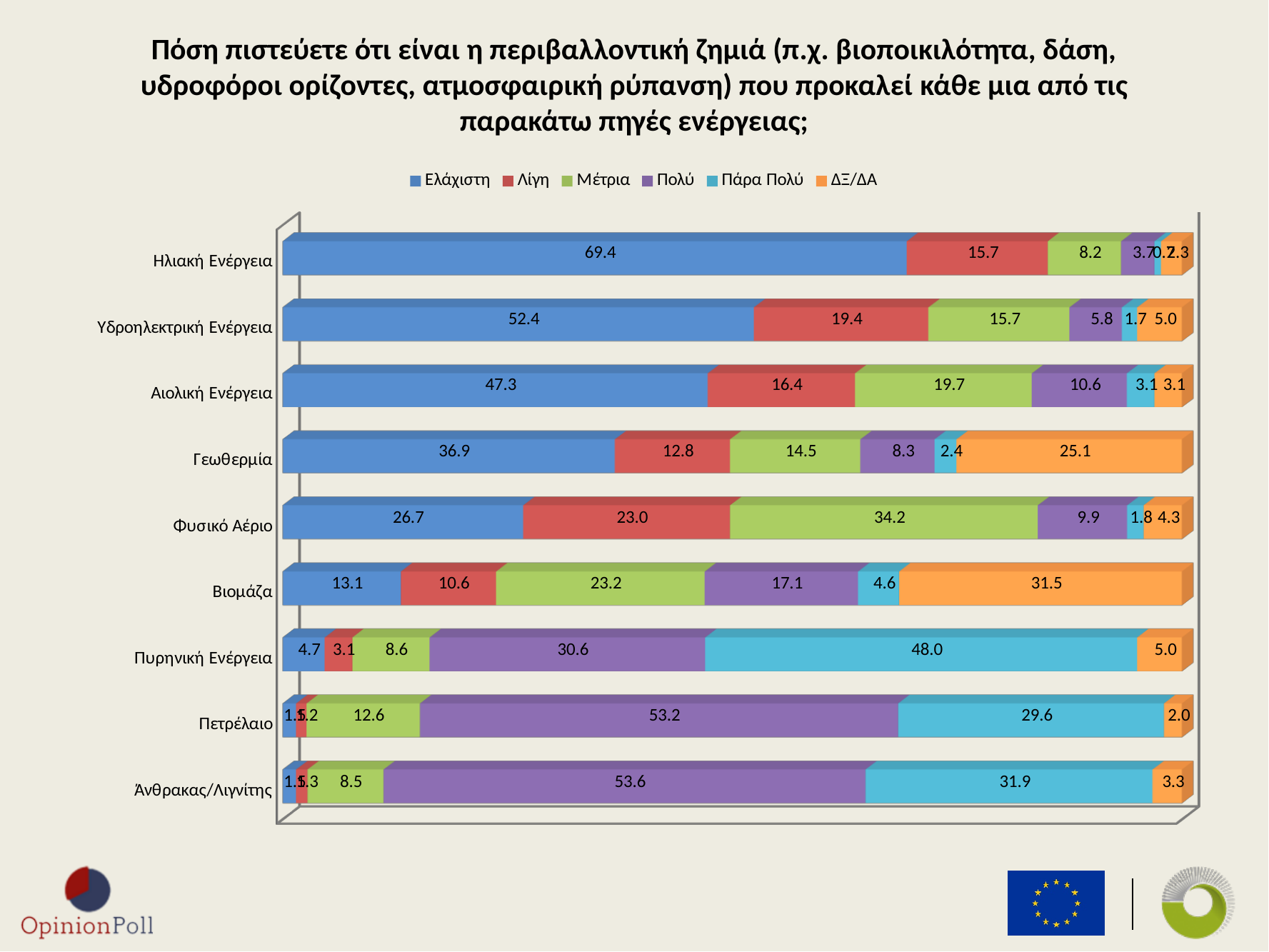
What kind of chart is shown on the slide? stacked bar chart What is the Ελάχιστη value for Ηλιακή Ενέργεια? 69.4 What is the ΔΞ/ΔΑ value for Βιομάζα? 31.5 How many series does the legend list? 6 How many energy sources (categories) are shown on the chart? 9 What is the Πάρα Πολύ value for Πυρηνική Ενέργεια? 48.0 Which energy source has the lowest Πολύ value? Ηλιακή Ενέργεια What is the Μέτρια value for Φυσικό Αέριο? 34.2 Which energy source has the highest Ελάχιστη value? Ηλιακή Ενέργεια Which colour represents the Πάρα Πολύ series in the legend? light blue What is the difference between the Πολύ values for Άνθρακας/Λιγνίτης and Πετρέλαιο? 0.4 Which is larger: the ΔΞ/ΔΑ value for Γεωθερμία or for Βιομάζα? Βιομάζα